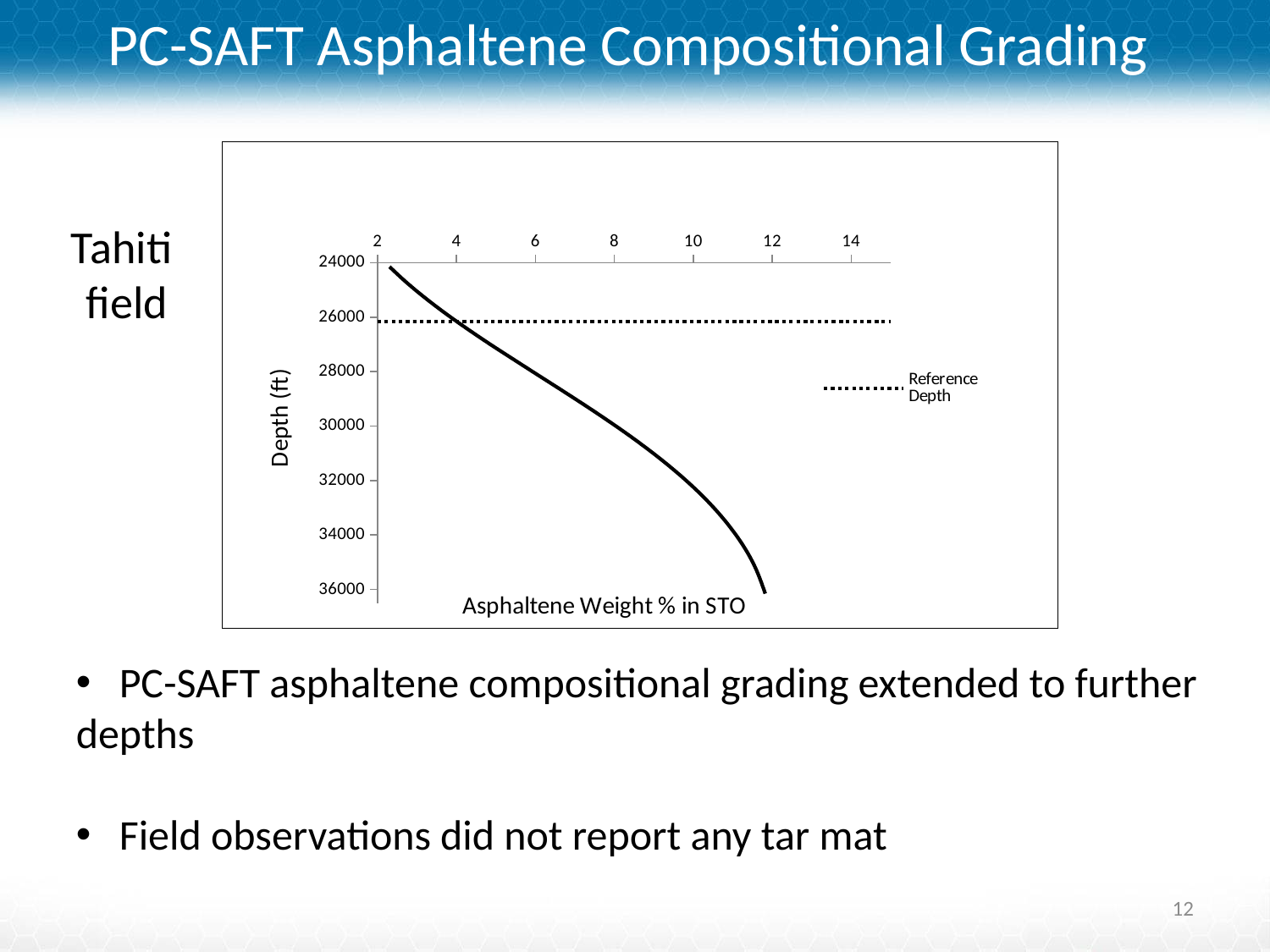
Is the Reference Depth shown by the dotted line greater or less than 28000 ft? less What kind of chart is shown on the slide? line chart What is the label on the vertical axis of the chart? Depth (ft) Is the asphaltene weight % at a depth of 30000 ft greater or less than 4? greater Is the asphaltene weight % at a depth of 32000 ft greater or less than 12? less What quantity is plotted on the horizontal axis of the chart? Asphaltene Weight % in STO As depth increases from 24000 ft to 36000 ft, does the asphaltene weight % in STO rise or fall? rise How many entries does the chart's legend list? 1 What is the name of the dotted horizontal line in the chart? Reference Depth What is the largest depth value labelled on the vertical axis? 36000